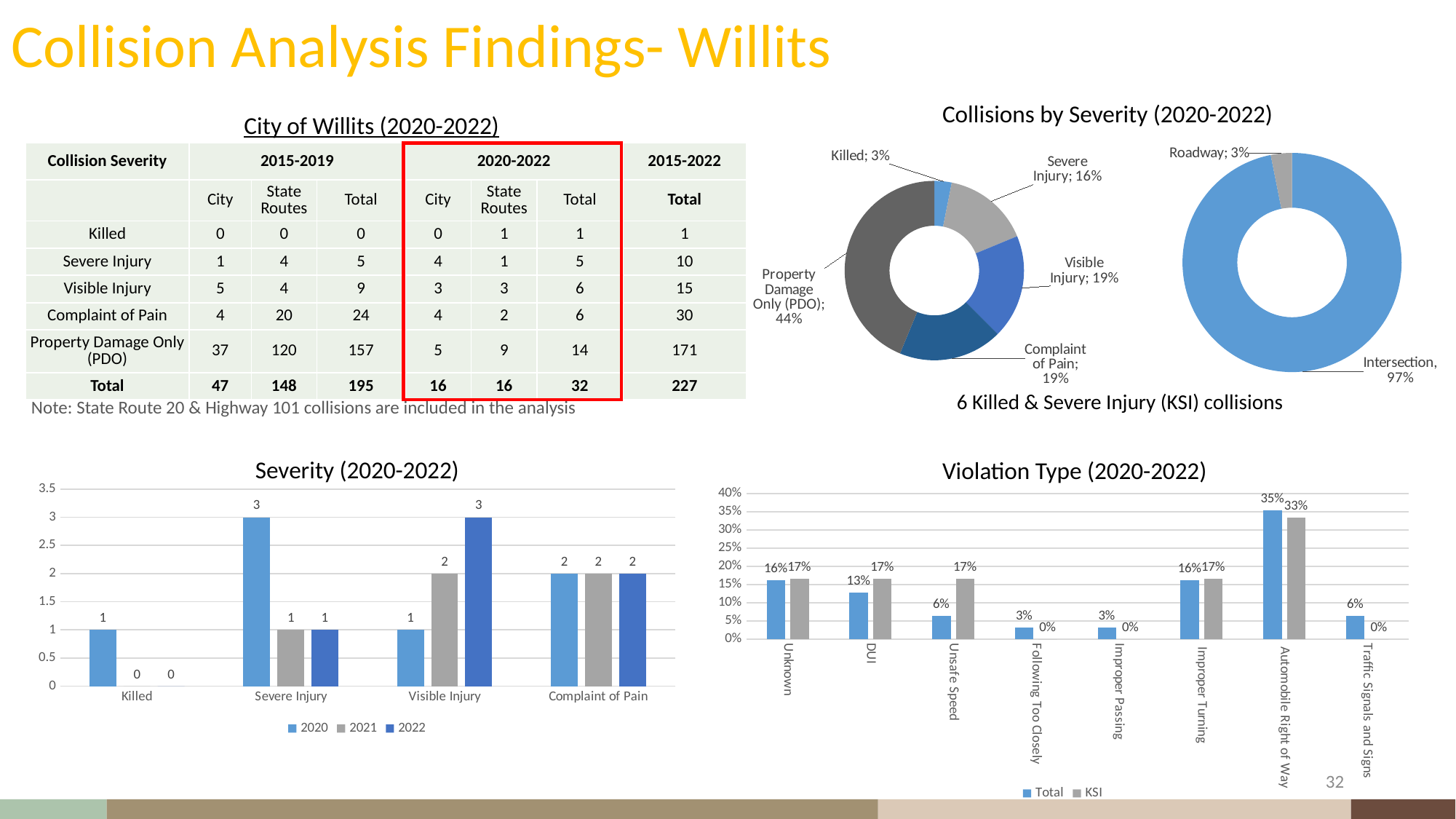
In the Severity (2020-2022) bar chart, do the values for Visible Injury rise or fall from 2020 to 2022? rise In the Severity (2020-2022) bar chart, how many series does the legend list? 3 In the Severity (2020-2022) bar chart, what is the value for Severe Injury in 2020? 3 In the Severity (2020-2022) bar chart, what is the difference between the 2020 and 2021 values for Severe Injury? 2 In the Violation Type (2020-2022) bar chart, which is larger for DUI, the Total value or the KSI value? KSI In the Violation Type (2020-2022) bar chart, what is the Total value for Automobile Right of Way? 35% In the donut chart on the right showing Roadway and Intersection, what share is Intersection? 97% In the Violation Type (2020-2022) bar chart, which violation type has the highest Total value? Automobile Right of Way In the Collisions by Severity (2020-2022) donut chart, what share is Property Damage Only (PDO)? 44% In the Severity (2020-2022) bar chart, what is the value for Visible Injury in 2022? 3 In the Violation Type (2020-2022) bar chart, how many violation type categories are shown? 8 In the Violation Type (2020-2022) bar chart, what is the KSI value for Unsafe Speed? 17%